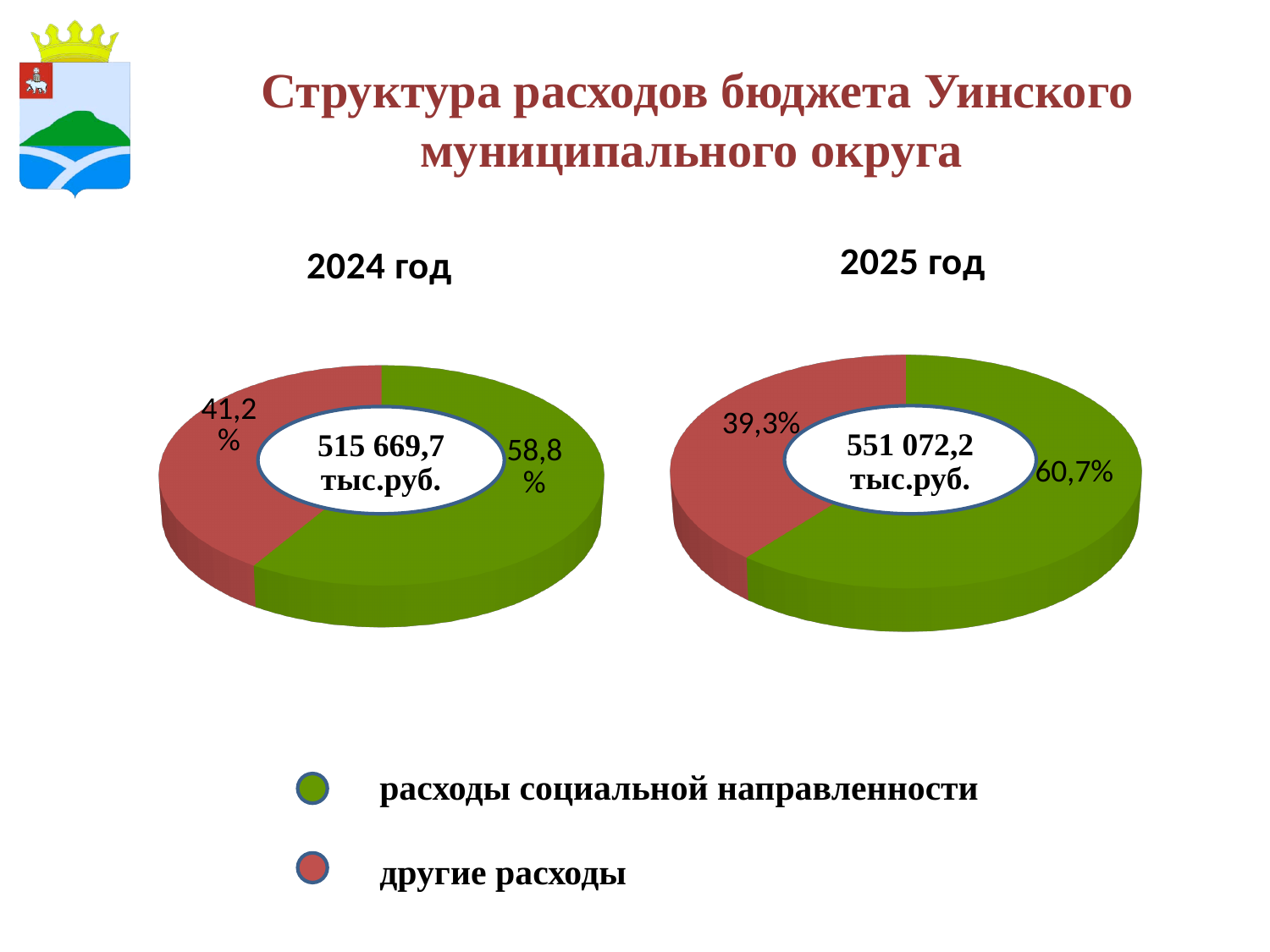
In the 2025 год chart, what share of expenditures is расходы социальной направленности? 60,7% In the 2025 год chart, which category has the largest share? расходы социальной направленности In the 2024 год chart, what share of expenditures is другие расходы? 41,2% In the 2024 год chart, what share of expenditures is расходы социальной направленности? 58,8% In the 2025 год chart, what share of expenditures is другие расходы? 39,3% How many categories does the legend list? 2 Which is larger: the share of расходы социальной направленности in 2024 год or in 2025 год? 2025 год What total amount is shown in the centre of the 2024 год chart? 515 669,7 тыс.руб. What type of chart is used for 2024 год and 2025 год? pie chart In the 2024 год chart, which category has the smallest share? другие расходы In the 2024 год chart, what is the difference in percentage points between расходы социальной направленности and другие расходы? 17,6 What total amount is shown in the centre of the 2025 год chart? 551 072,2 тыс.руб.